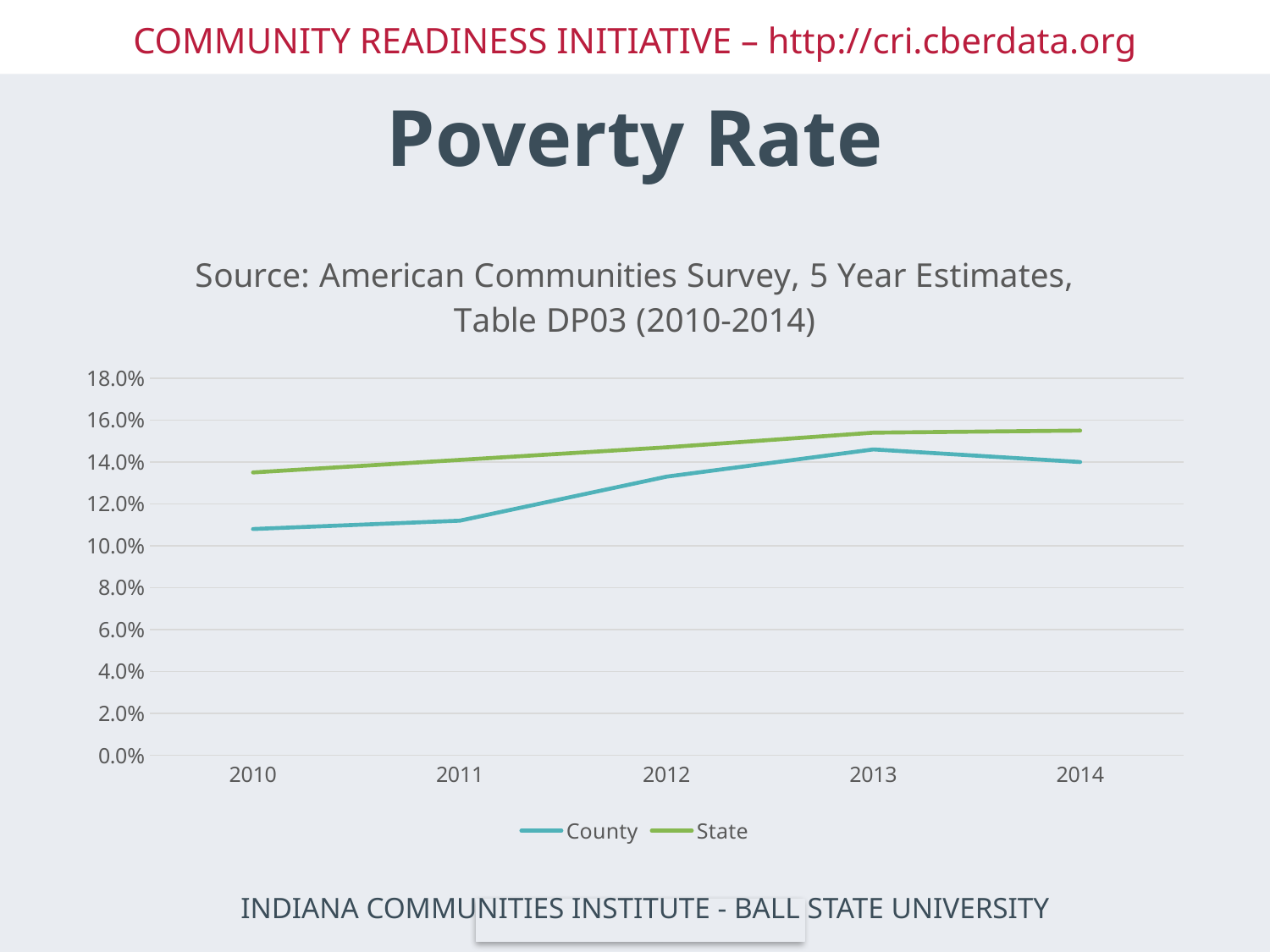
Is the County value for 2013 greater or less than 14.0%? greater In which year is the State poverty rate lowest? 2010 What is the title of the chart? Poverty Rate Does the State poverty rate rise or fall from 2010 to 2014? Rise In which year is the County poverty rate highest? 2013 Is the County value for 2010 greater or less than 12.0%? less In which year is the County poverty rate lowest? 2010 How many years are plotted along the x axis? 5 What kind of chart is shown on the slide? Line chart Which series is higher in 2010, County or State? State Is the State value for 2014 greater or less than 14.0%? greater How many series does the legend list? 2